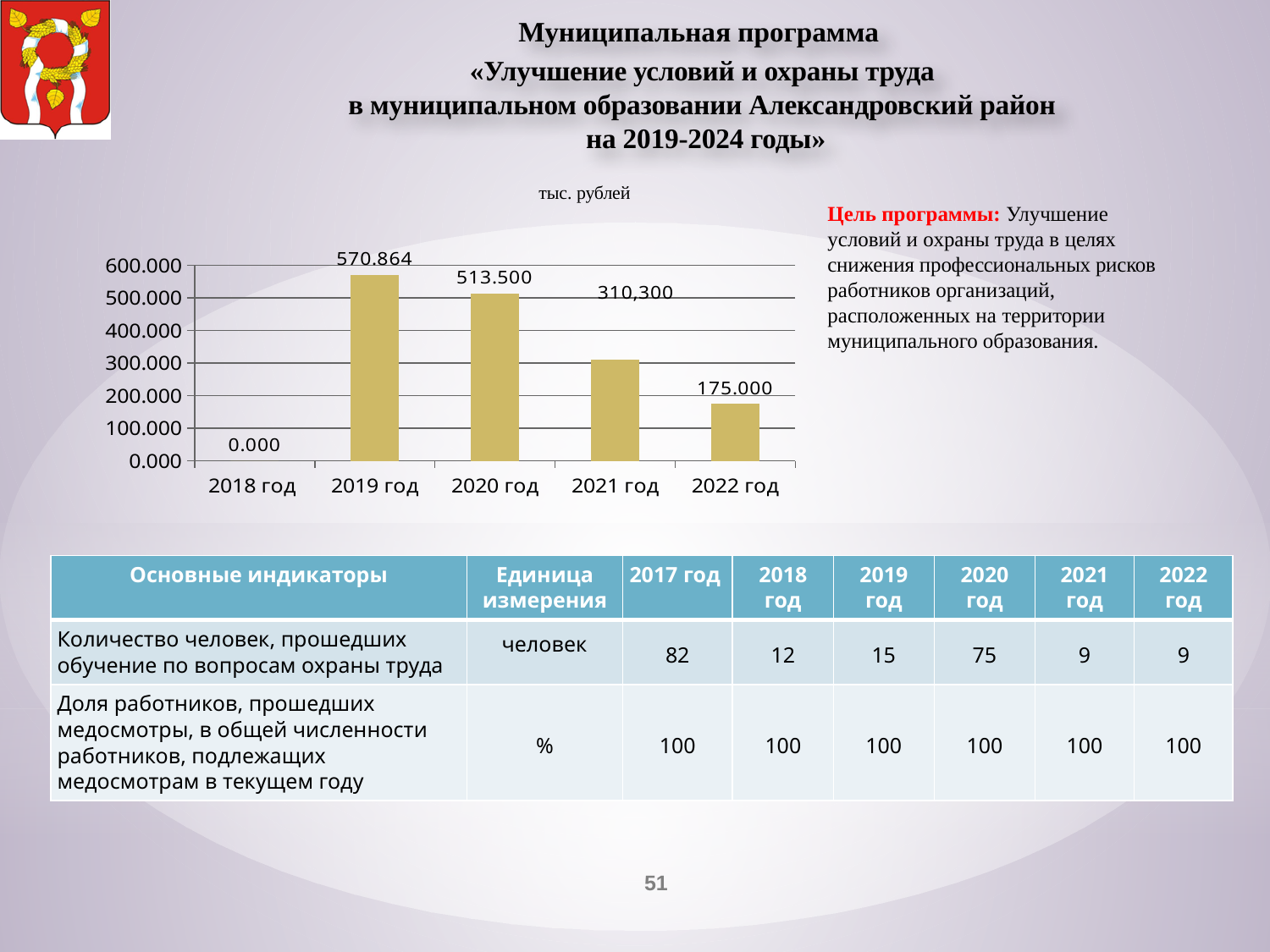
Is the value for 2022 год greater or less than 200.000? less Which is larger, the value for 2020 год or the value for 2021 год? 2020 год Which year has the highest value in the chart? 2019 год What is the value for 2018 год in the chart? 0.000 What is the value for 2019 год in the chart? 570.864 What is the value for 2020 год in the chart? 513.500 What unit is indicated above the chart? тыс. рублей Which year has the lowest value in the chart? 2018 год What is the difference between the values for 2019 год and 2020 год? 57.364 What is the value for 2022 год in the chart? 175.000 How many years are shown on the x axis of the chart? 5 What kind of chart is shown on the slide? bar chart